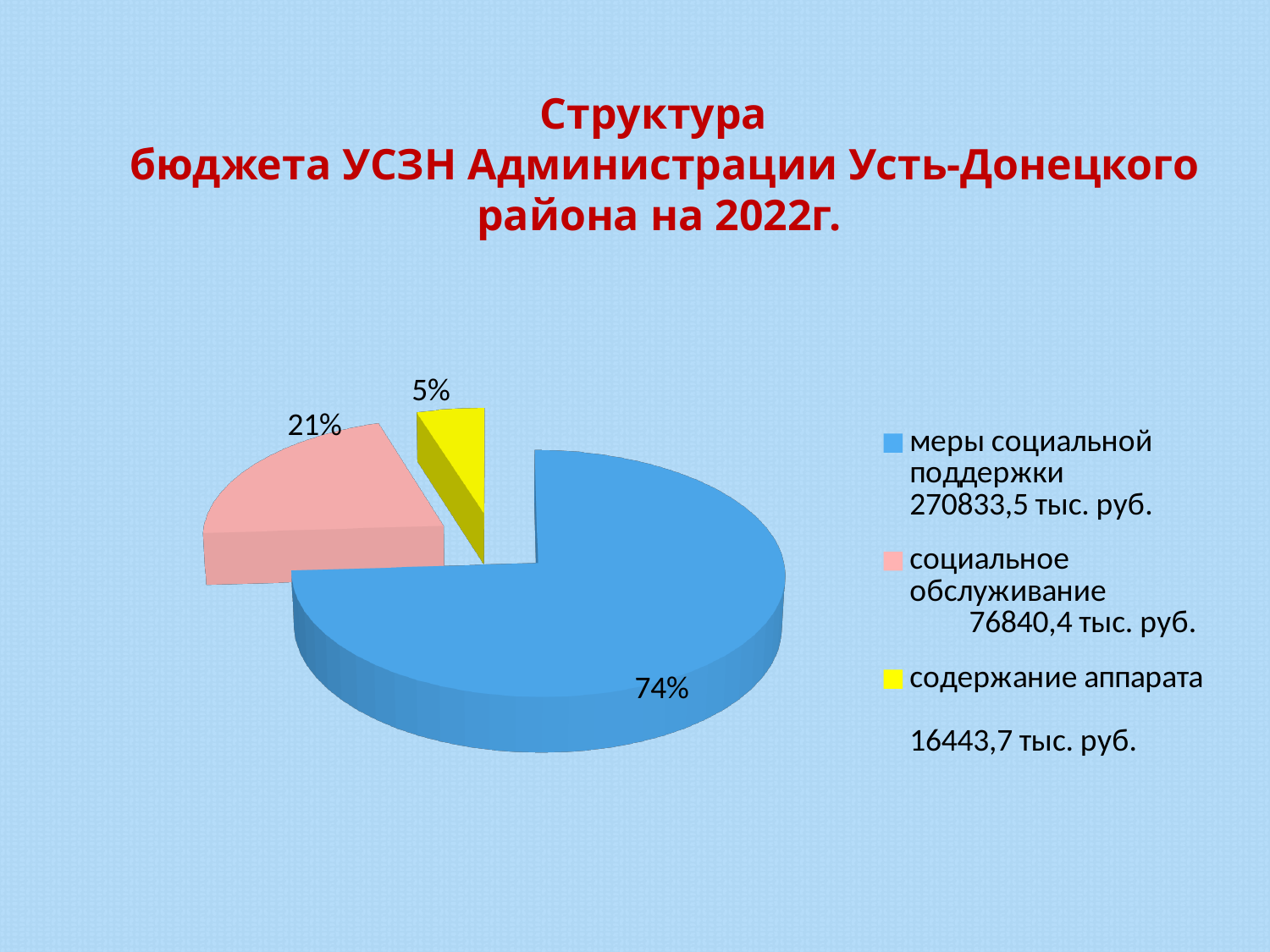
What amount in thousand rubles does the legend give for "социальное обслуживание"? 76840,4 тыс. руб. How many slices does the pie chart have? 3 Which category has the largest slice of the pie? меры социальной поддержки Which is larger: the share for "социальное обслуживание" or the share for "содержание аппарата"? социальное обслуживание What is the difference in percentage points between the shares of "меры социальной поддержки" and "социальное обслуживание"? 53 How many entries does the legend list? 3 What share of the pie does "содержание аппарата" take? 5% What share of the pie does "социальное обслуживание" take? 21% What colour is the slice for "содержание аппарата"? yellow What share of the pie does "меры социальной поддержки" take? 74% What kind of chart is shown on the slide? pie chart Which category has the smallest slice of the pie? содержание аппарата